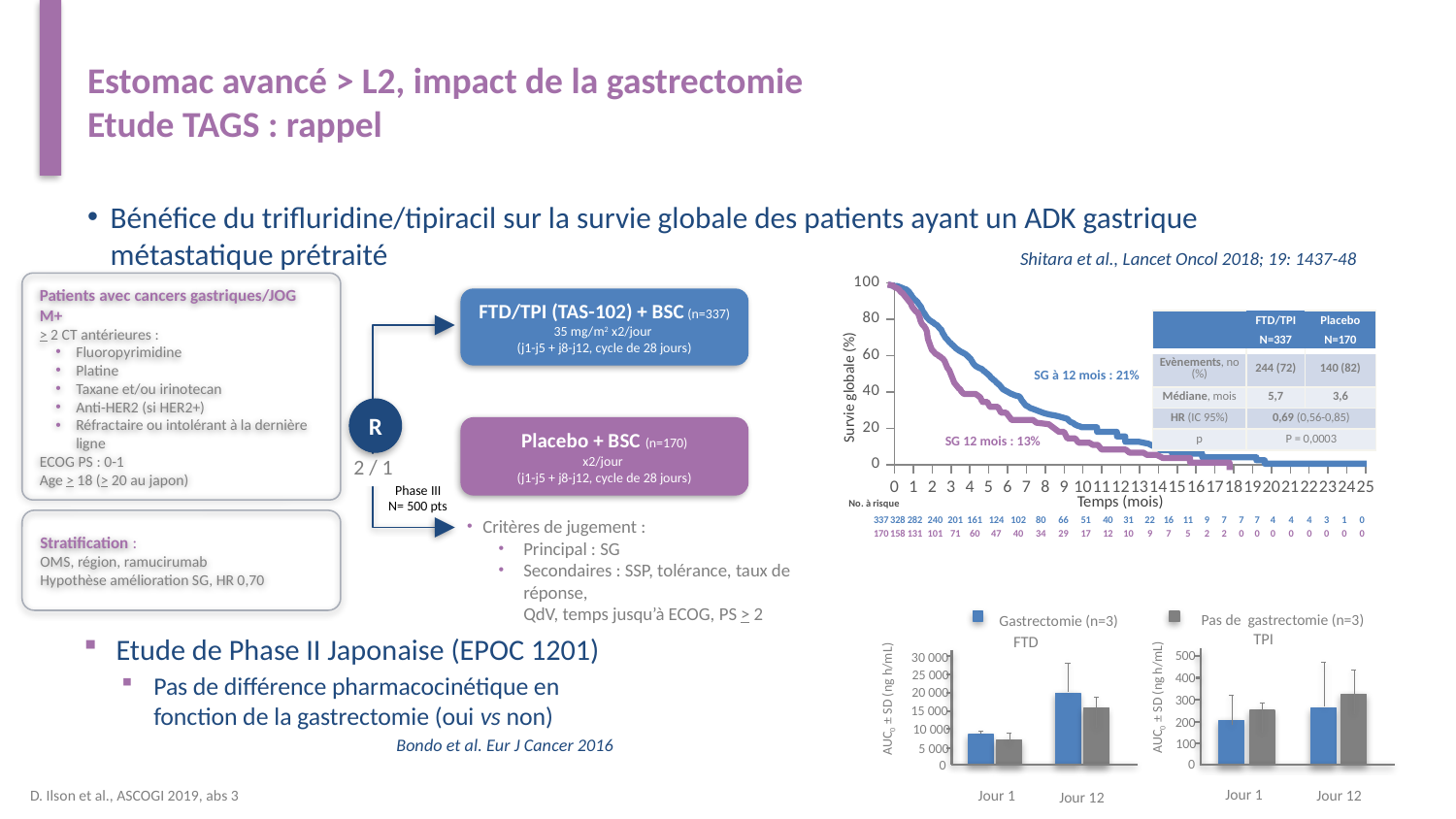
In the FTD bar chart at the bottom right, is the value for Gastrectomie at Jour 12 greater or less than 15 000? greater In the survival chart at the top right, what is the 12-month overall survival (SG à 12 mois) for the FTD/TPI arm? 21% What kind of chart is the survival chart at the top right of the slide? Line chart (Kaplan-Meier survival curve) In the survival chart at the top right, what hazard ratio (HR) is shown in the inset table? 0,69 (0,56-0,85) In the TPI bar chart at the bottom right, which is larger at Jour 12: Gastrectomie or Pas de gastrectomie? Pas de gastrectomie How many series does the legend of the bottom-right bar charts list? 2 In the survival chart at the top right, what is the difference in 12-month overall survival between the FTD/TPI arm and the placebo arm? 8 percentage points In the FTD bar chart at the bottom right, is the value for Gastrectomie at Jour 1 greater or less than 10 000? less In the survival chart at the top right, what is the median survival (Médiane, mois) for the placebo arm according to the inset table? 3,6 What kind of charts are the two AUC charts (FTD and TPI) at the bottom right of the slide? Bar charts In the survival chart at the top right, what is the 12-month overall survival (SG 12 mois) for the placebo arm? 13% In the FTD bar chart at the bottom right, do the values rise or fall from Jour 1 to Jour 12? Rise